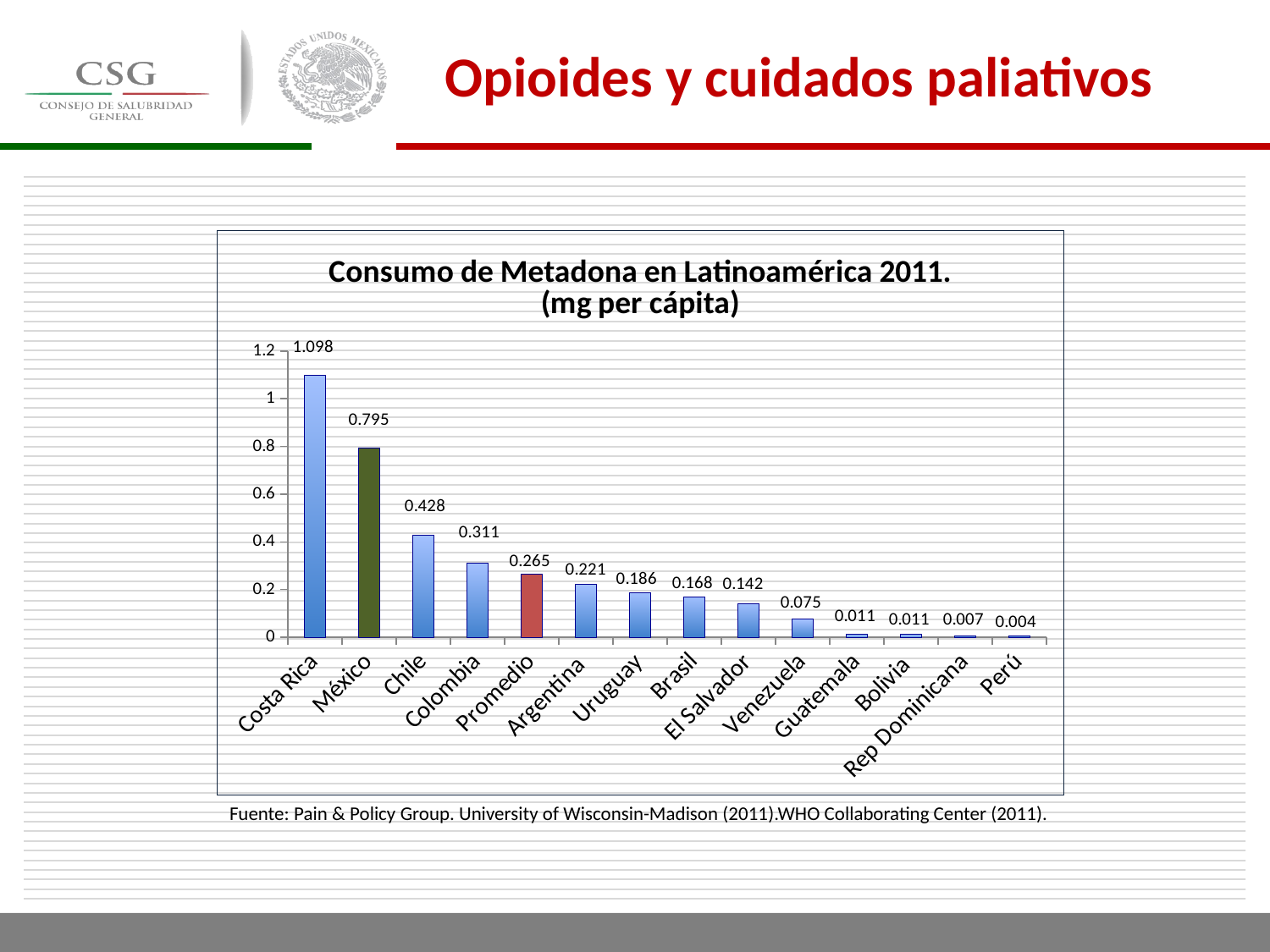
What is the difference between the values for Costa Rica and México? 0.303 Is the value for Chile greater or less than 0.4? greater How many categories are shown on the x axis? 14 Which country has the lowest methadone consumption? Perú What is the difference between the values for Chile and Colombia? 0.117 Which country has the highest methadone consumption? Costa Rica What kind of chart is shown on the slide? bar chart Do the values rise or fall from left to right along the x axis? fall What is the value for México? 0.795 Which is larger, the value for Argentina or the value for Uruguay? Argentina What is the value for Venezuela? 0.075 What is the value for Promedio? 0.265